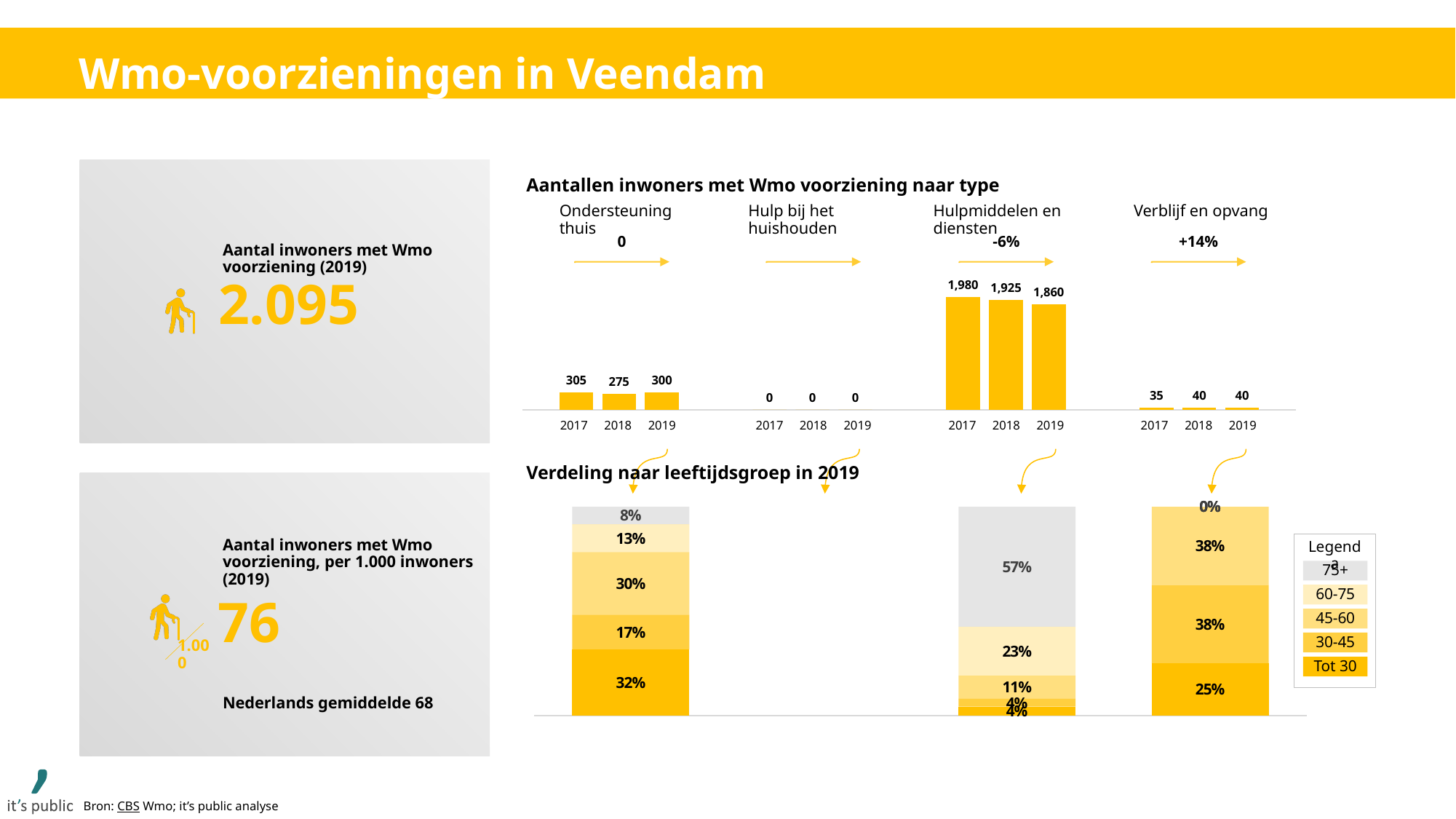
In the chart 'Aantallen inwoners met Wmo voorziening naar type', what is the value for Hulpmiddelen en diensten in 2019? 1,860 In the chart 'Verdeling naar leeftijdsgroep in 2019', what share of the Hulpmiddelen en diensten bar is the 75+ age group? 57% What kind of chart is 'Aantallen inwoners met Wmo voorziening naar type'? bar chart How many age groups does the legend of the chart 'Verdeling naar leeftijdsgroep in 2019' list? 5 In the chart 'Aantallen inwoners met Wmo voorziening naar type', which is larger for Ondersteuning thuis: the 2017 value or the 2019 value? 2017 In the chart 'Verdeling naar leeftijdsgroep in 2019', what share of the Ondersteuning thuis bar is the Tot 30 age group? 32% In the chart 'Aantallen inwoners met Wmo voorziening naar type', do the values for Hulpmiddelen en diensten rise or fall from 2017 to 2019? fall In the chart 'Aantallen inwoners met Wmo voorziening naar type', what percentage change is shown above the arrow for Verblijf en opvang? +14% In the chart 'Aantallen inwoners met Wmo voorziening naar type', what is the value for Verblijf en opvang in 2017? 35 In the chart 'Aantallen inwoners met Wmo voorziening naar type', what is the value for Ondersteuning thuis in 2018? 275 In the chart 'Aantallen inwoners met Wmo voorziening naar type', which year has the highest value for Hulpmiddelen en diensten? 2017 In the chart 'Aantallen inwoners met Wmo voorziening naar type', what is the difference between the 2017 and 2019 values for Hulpmiddelen en diensten? 120